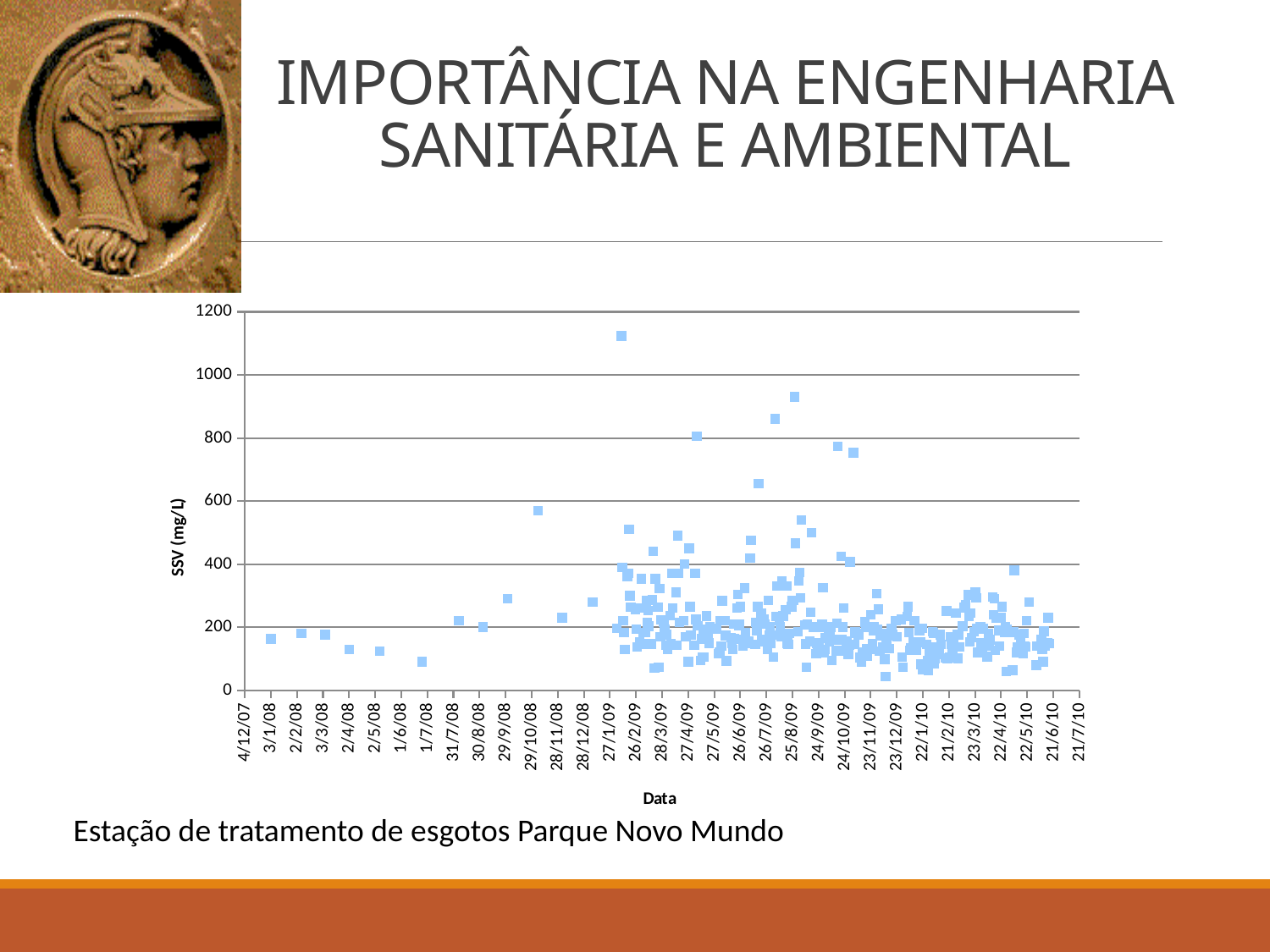
What is the label of the vertical axis of the chart? SSV (mg/L) Is the highest plotted value on the chart greater or less than 1000? greater Which is larger: the value plotted at 2/5/08 or the value plotted near 29/10/08? the value near 29/10/08 Is the value plotted at 1/7/08 greater or less than 200? less What kind of chart is shown on the slide? scatter chart Is the value plotted at 2/4/08 greater or less than 200? less What is the label of the horizontal axis of the chart? Data Which is larger: the value plotted at 3/1/08 or the highest value plotted near 27/1/09? the highest value near 27/1/09